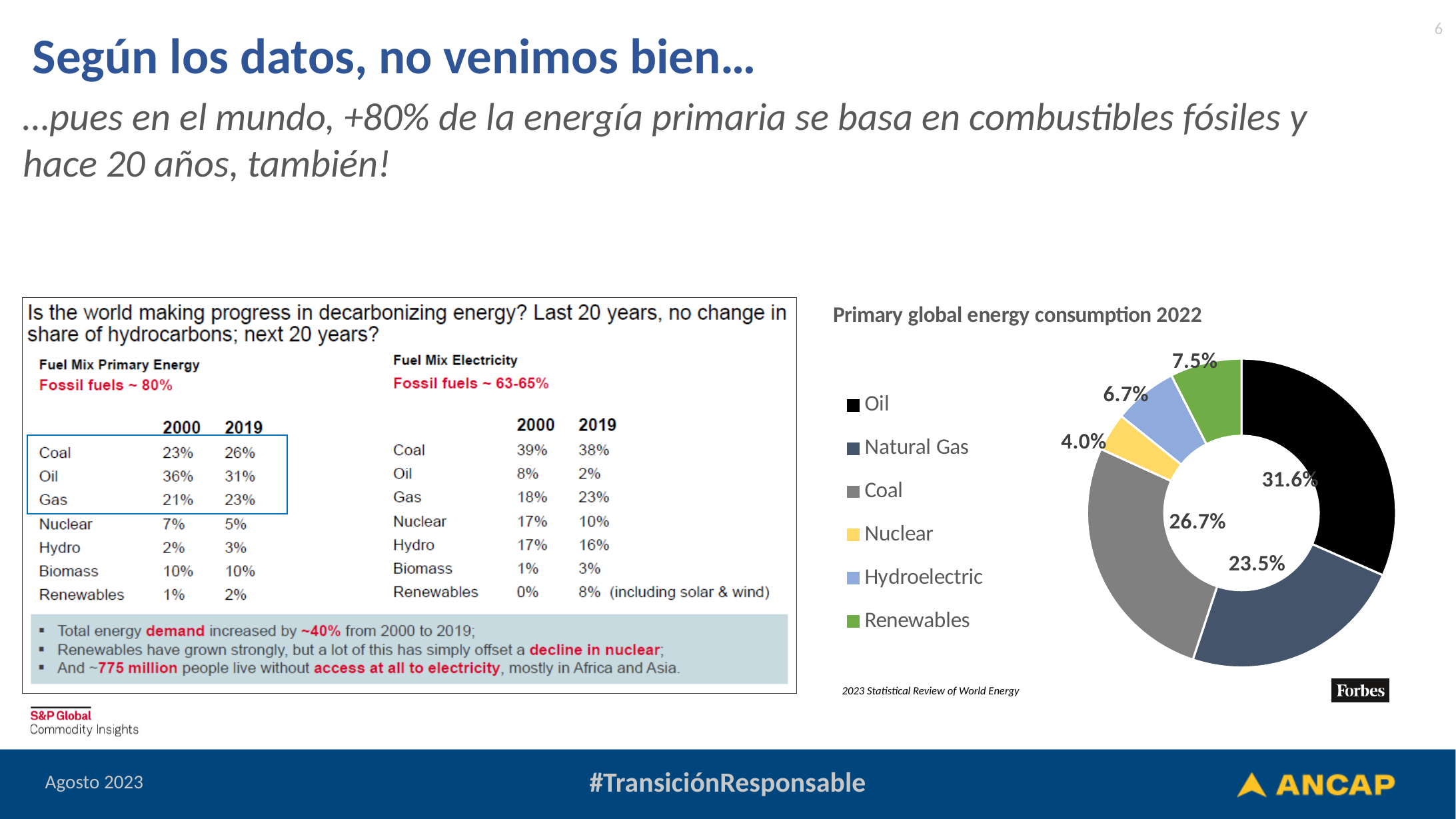
In the 'Primary global energy consumption 2022' chart, what colour represents Coal? Grey In the 'Primary global energy consumption 2022' chart, what share does Hydroelectric have? 6.7% In the 'Primary global energy consumption 2022' chart, what share does Nuclear have? 4.0% In the 'Primary global energy consumption 2022' chart, which energy source has the smallest share? Nuclear In the 'Primary global energy consumption 2022' chart, what share does Oil have? 31.6% In the 'Primary global energy consumption 2022' chart, which has a larger share, Renewables or Hydroelectric? Renewables In the 'Primary global energy consumption 2022' chart, what share does Coal have? 26.7% In the 'Primary global energy consumption 2022' chart, which energy source has the largest share? Oil In the 'Primary global energy consumption 2022' chart, what share does Natural Gas have? 23.5% How many energy sources are shown in the 'Primary global energy consumption 2022' chart? 6 What kind of chart is 'Primary global energy consumption 2022'? Pie (doughnut) chart In the 'Primary global energy consumption 2022' chart, what is the difference between the shares of Oil and Natural Gas? 8.1%